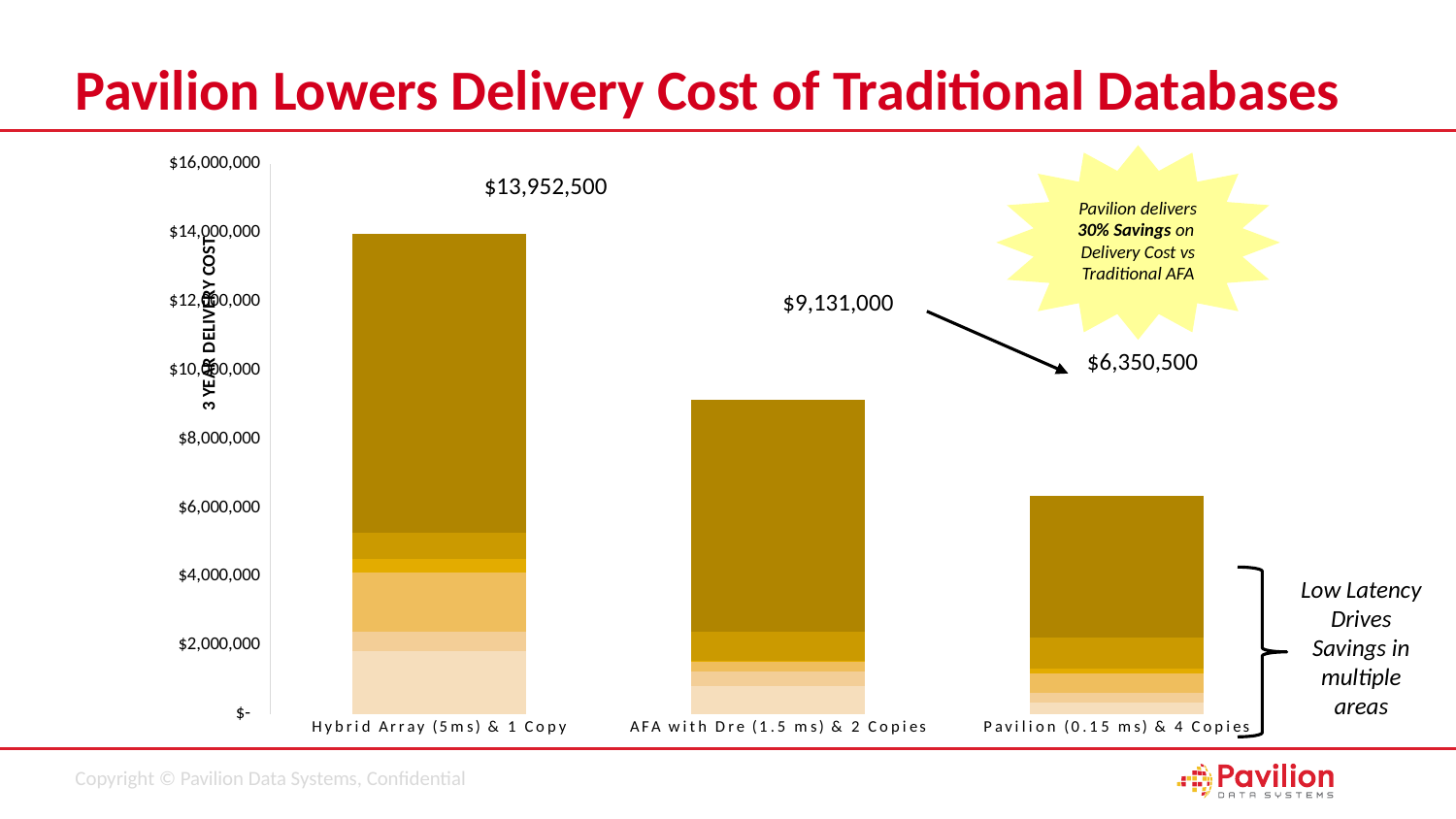
Is the total value for Pavilion (0.15 ms) & 4 Copies greater or less than $8,000,000? less What is the total 3 year delivery cost shown for Hybrid Array (5ms) & 1 Copy? $13,952,500 What is the difference between the total cost for Hybrid Array (5ms) & 1 Copy and the total cost for AFA with Dre (1.5 ms) & 2 Copies? $4,821,500 What is the difference between the total cost for AFA with Dre (1.5 ms) & 2 Copies and the total cost for Pavilion (0.15 ms) & 4 Copies? $2,780,500 Which has a larger total 3 year delivery cost, AFA with Dre (1.5 ms) & 2 Copies or Pavilion (0.15 ms) & 4 Copies? AFA with Dre (1.5 ms) & 2 Copies Which category has the lowest total 3 year delivery cost? Pavilion (0.15 ms) & 4 Copies Which category has the highest total 3 year delivery cost? Hybrid Array (5ms) & 1 Copy What kind of chart is shown on the slide? Stacked bar chart Do the total values rise or fall moving from left to right along the x axis? Fall How many categories are shown on the x axis of the chart? 3 What is the total 3 year delivery cost shown for Pavilion (0.15 ms) & 4 Copies? $6,350,500 What is the total 3 year delivery cost shown for AFA with Dre (1.5 ms) & 2 Copies? $9,131,000